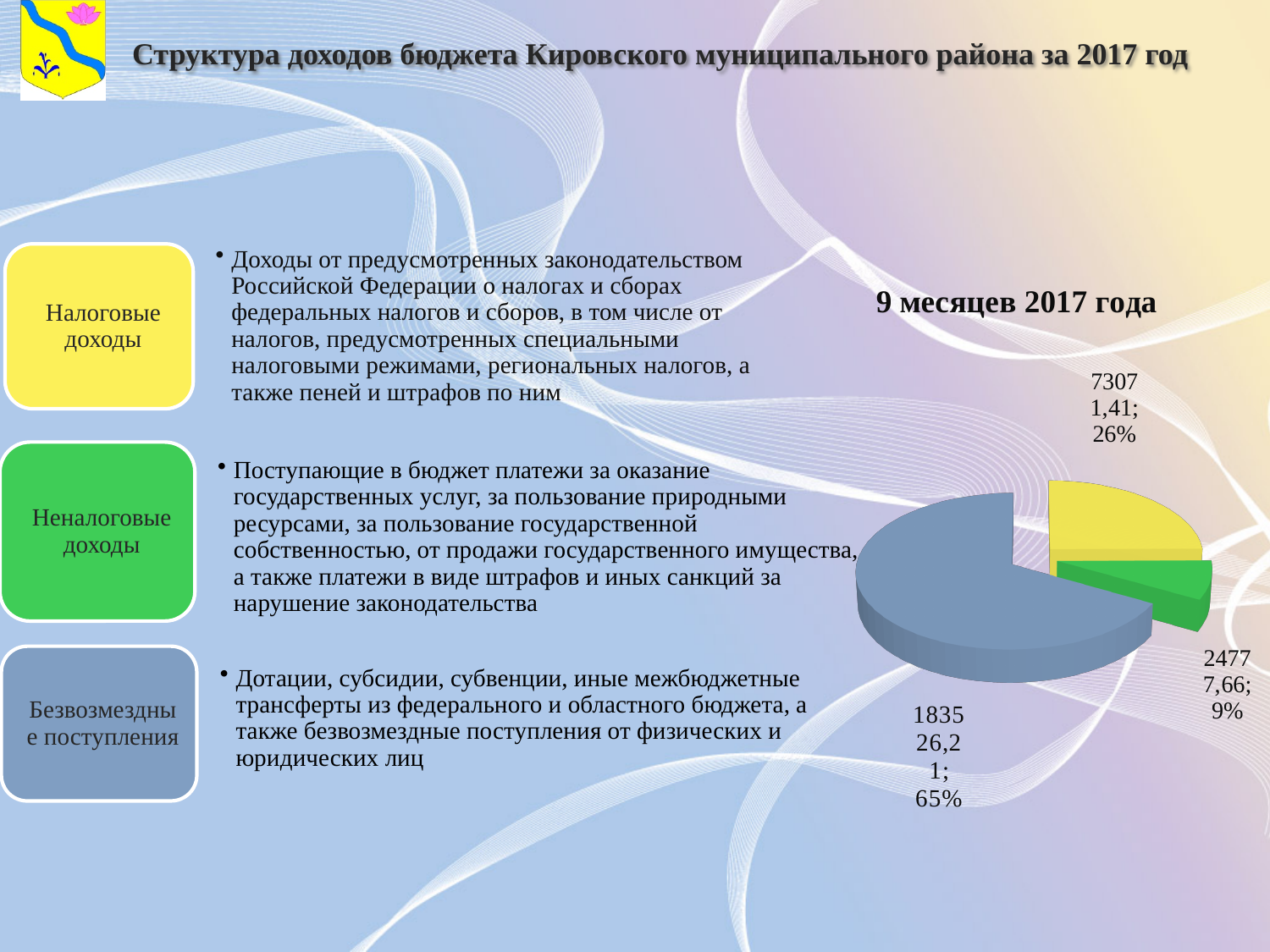
What share of the pie does the yellow slice represent? 26% What is the title of the chart? 9 месяцев 2017 года How many slices does the pie chart have? 3 Which slice of the pie chart is the smallest? the green slice (9%) What value is labelled on the blue slice of the pie chart? 183526,21 What value is labelled on the green slice of the pie chart? 24777,66 What share of the pie does the green slice represent? 9% Which slice of the pie chart is the largest? the blue slice (65%) What share of the pie does the blue slice represent? 65% What kind of chart is shown on the slide? pie chart What value is labelled on the yellow slice of the pie chart? 73071,41 By how many percentage points does the yellow slice's share exceed the green slice's share? 17 percentage points